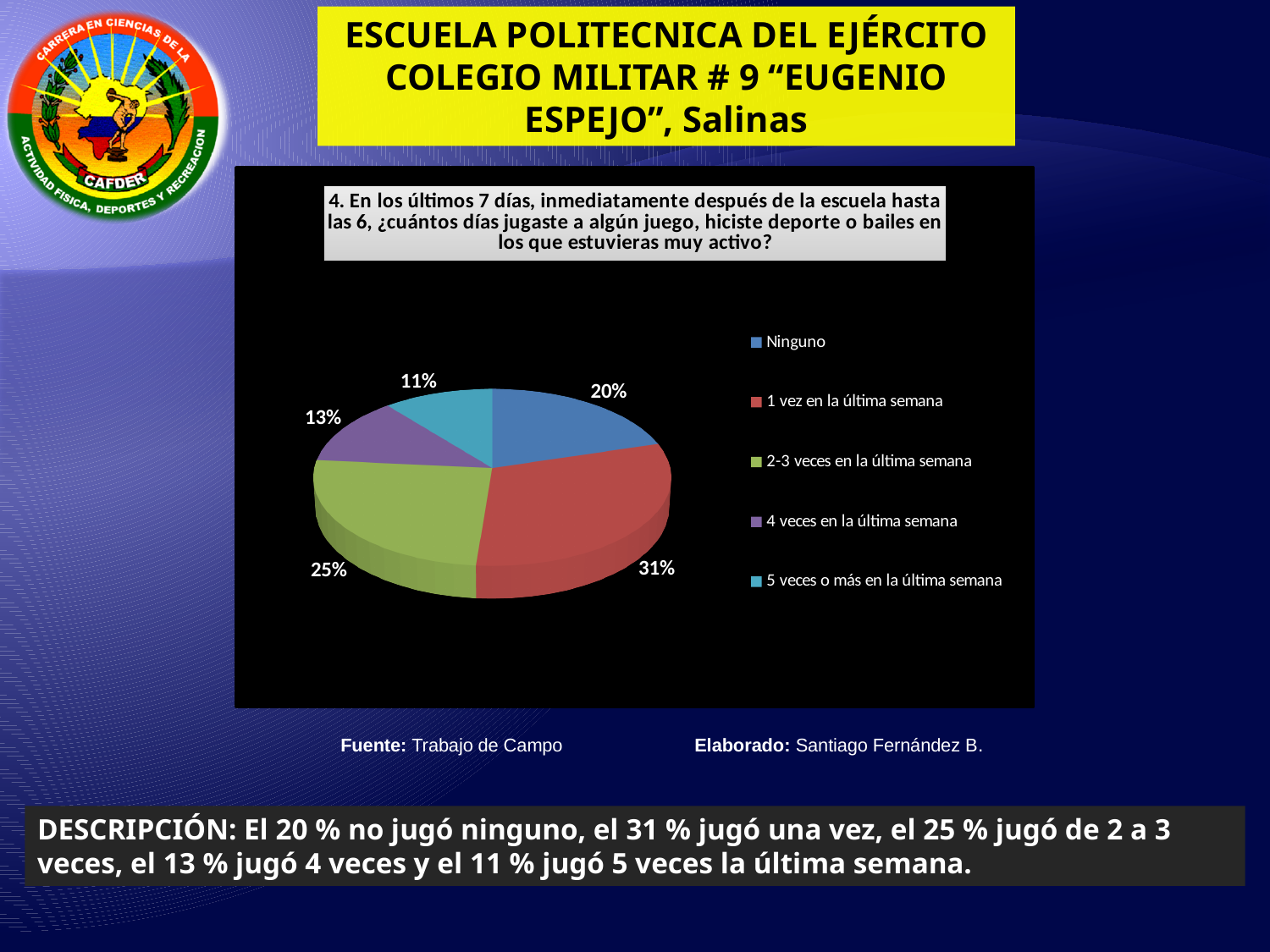
What colour is the slice for 'Ninguno'? Blue What percentage of the pie corresponds to 'Ninguno'? 20% What percentage of the pie corresponds to '1 vez en la última semana'? 31% What is the difference in percentage points between '1 vez en la última semana' and 'Ninguno'? 11 What percentage of the pie corresponds to '5 veces o más en la última semana'? 11% Which category has the smallest slice of the pie? 5 veces o más en la última semana Which is larger: the slice for '2-3 veces en la última semana' or the slice for '4 veces en la última semana'? 2-3 veces en la última semana What percentage of the pie corresponds to '2-3 veces en la última semana'? 25% What percentage of the pie corresponds to '4 veces en la última semana'? 13% Which category has the largest slice of the pie? 1 vez en la última semana What kind of chart is shown on the slide? Pie chart How many categories does the legend list? 5